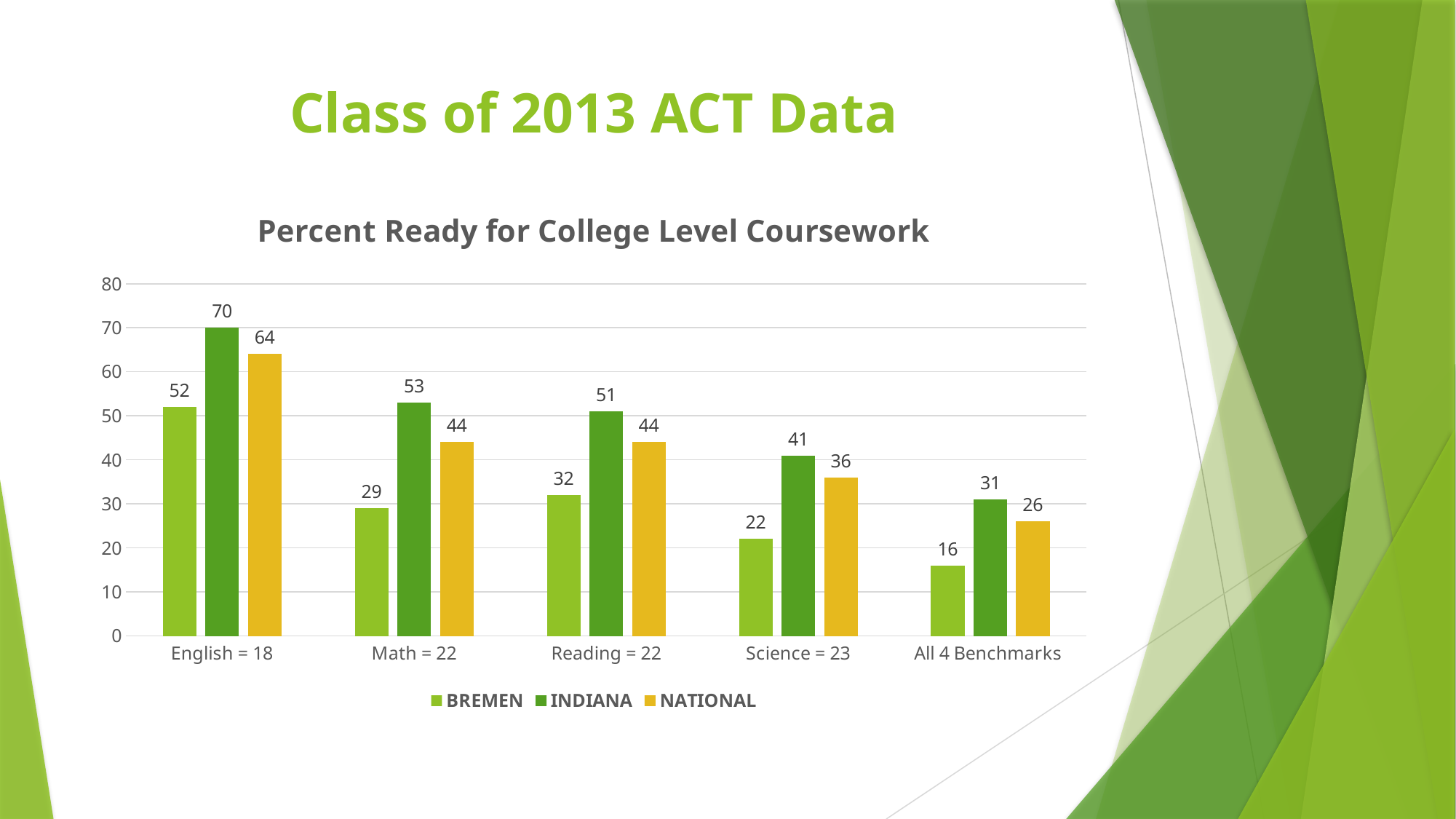
How many series does the legend list? 3 What is the INDIANA value for Science = 23? 41 What kind of chart is shown? bar chart What is the BREMEN value for English = 18? 52 How many categories are shown on the x axis? 5 What is the title of the chart? Percent Ready for College Level Coursework What is the NATIONAL value for All 4 Benchmarks? 26 What is the difference between the INDIANA and BREMEN values for Math = 22? 24 Is the BREMEN value for Science = 23 greater or less than 30? less Which category has the highest INDIANA value? English = 18 Which is larger for Reading = 22, the INDIANA value or the NATIONAL value? INDIANA Which category has the lowest BREMEN value? All 4 Benchmarks